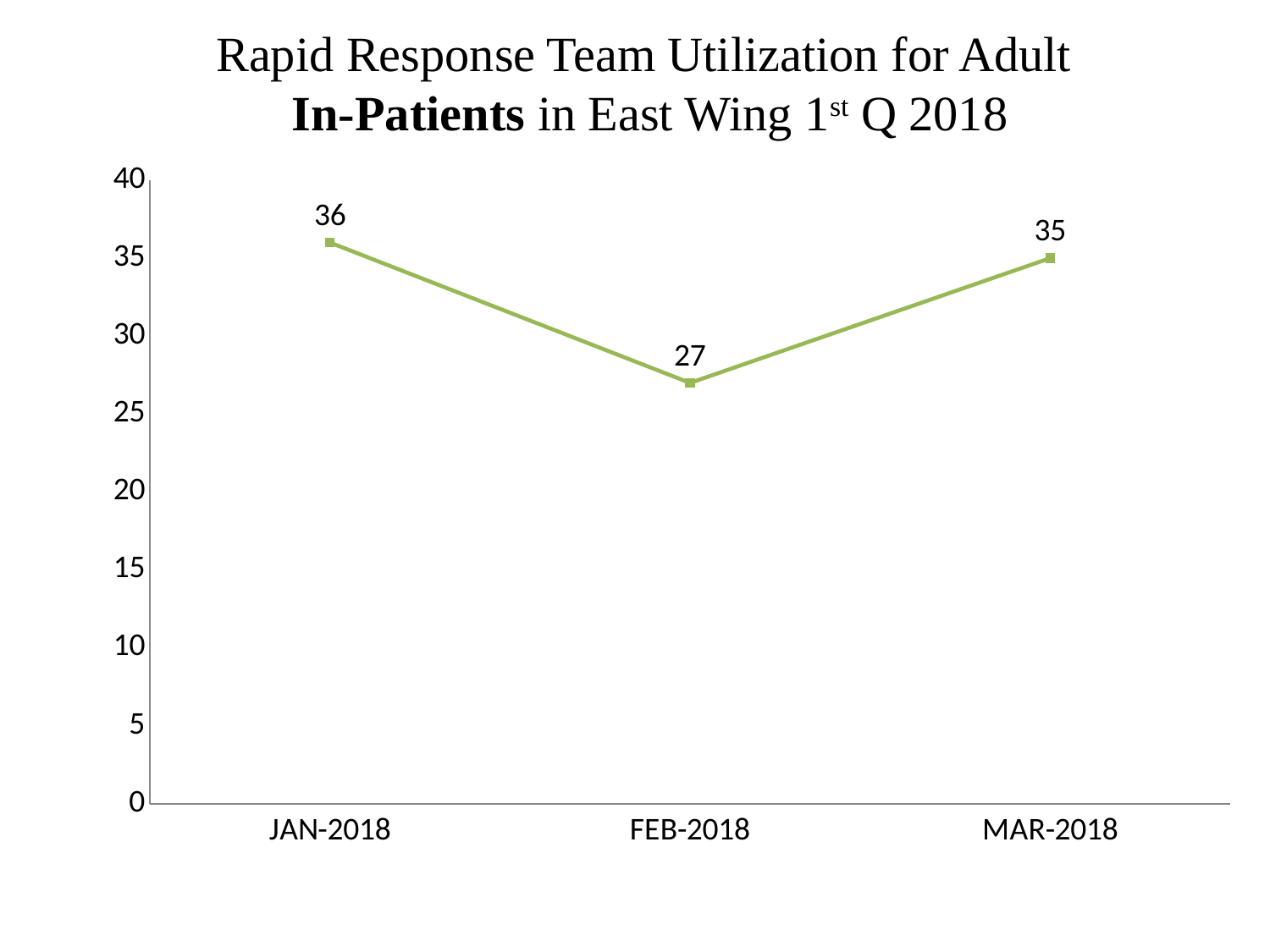
What is the value for JAN-2018? 36 What is the value for FEB-2018? 27 What is the value for MAR-2018? 35 Which is larger, the value for JAN-2018 or the value for FEB-2018? JAN-2018 Which month has the lowest value? FEB-2018 Is the value for FEB-2018 greater or less than 30? less How many months are plotted on the chart? 3 What is the difference between the values for MAR-2018 and FEB-2018? 8 What kind of chart is shown on the slide? line chart Does the value rise or fall from FEB-2018 to MAR-2018? rise Which month has the highest value? JAN-2018 What is the difference between the values for JAN-2018 and FEB-2018? 9